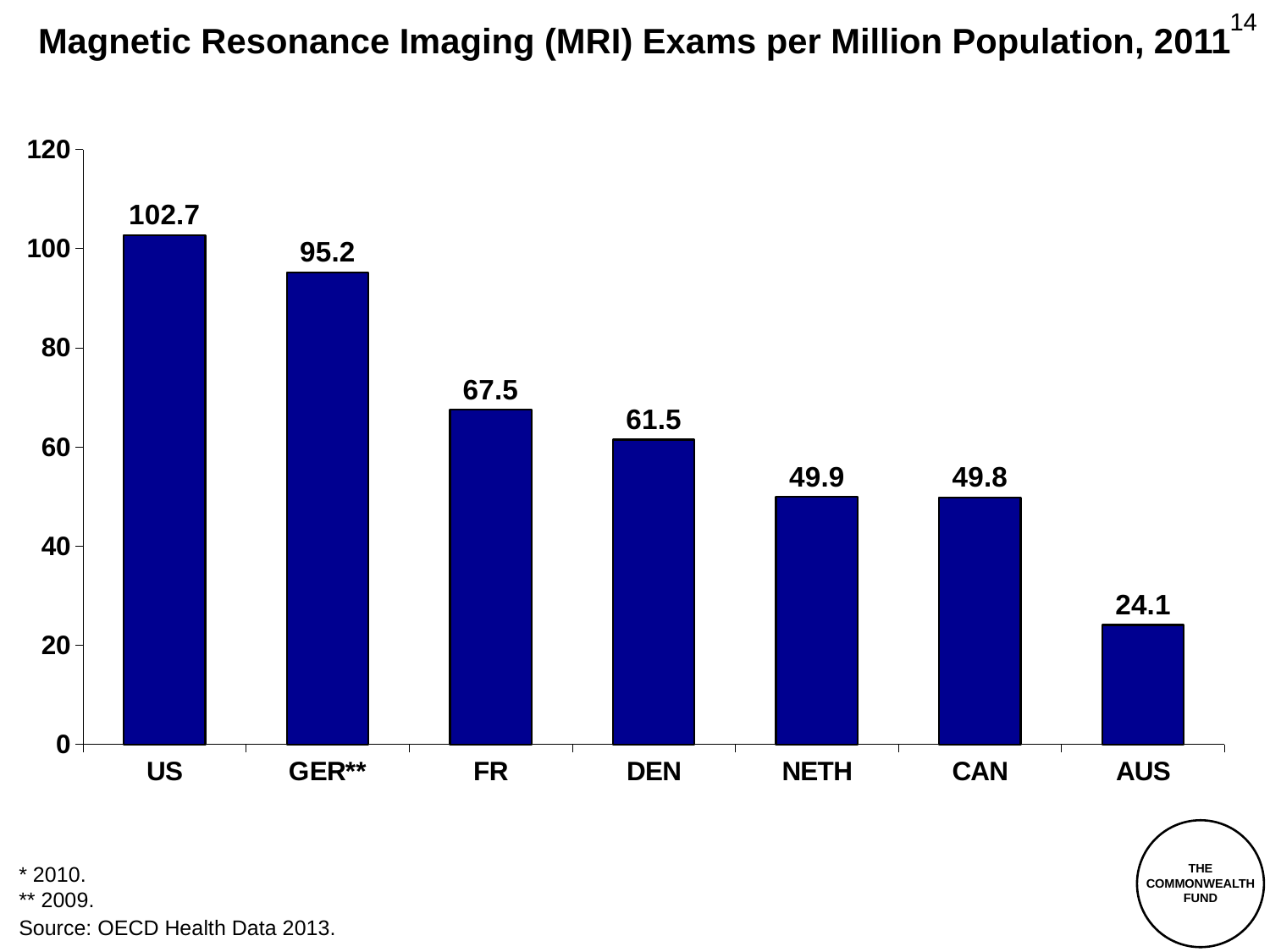
How many countries are shown on the chart? 7 What kind of chart is this? Bar chart What is the value for US? 102.7 What is the value for GER**? 95.2 Which country has the highest value? US Do the values rise or fall from left to right along the x axis? Fall What is the value for AUS? 24.1 What is the difference between the values for FR and AUS? 43.4 Which is larger, the value for FR or the value for DEN? FR What is the value for DEN? 61.5 Which country has the lowest value? AUS What is the difference between the values for US and GER**? 7.5